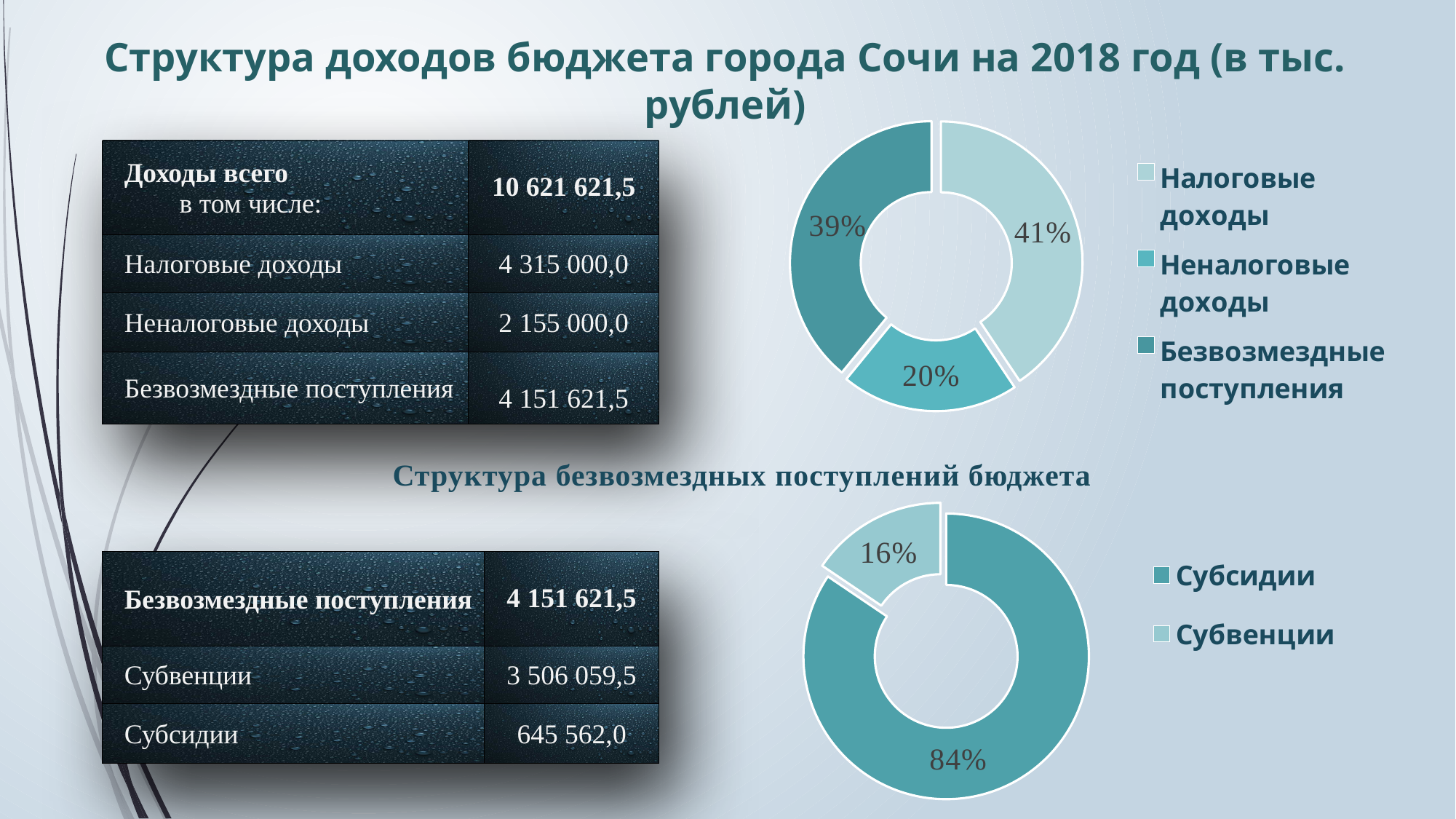
In the top donut chart, what share is shown for Безвозмездные поступления? 39% How many categories does the top donut chart show? 3 In the chart 'Структура безвозмездных поступлений бюджета', what share does the larger slice show? 84% In the top donut chart, what is the difference in percentage points between Налоговые доходы and Неналоговые доходы? 21 In the top donut chart, which is larger: Безвозмездные поступления or Неналоговые доходы? Безвозмездные поступления What type of chart is used under the title 'Структура безвозмездных поступлений бюджета'? Donut (pie) chart In the top donut chart, which category has the smallest share? Неналоговые доходы In the top donut chart, what share is shown for Неналоговые доходы? 20% In the chart 'Структура безвозмездных поступлений бюджета', what share does the smaller slice show? 16% In the top donut chart, what share is shown for Налоговые доходы? 41% In the top donut chart, which category has the largest share? Налоговые доходы How many entries does the legend of the chart 'Структура безвозмездных поступлений бюджета' list? 2